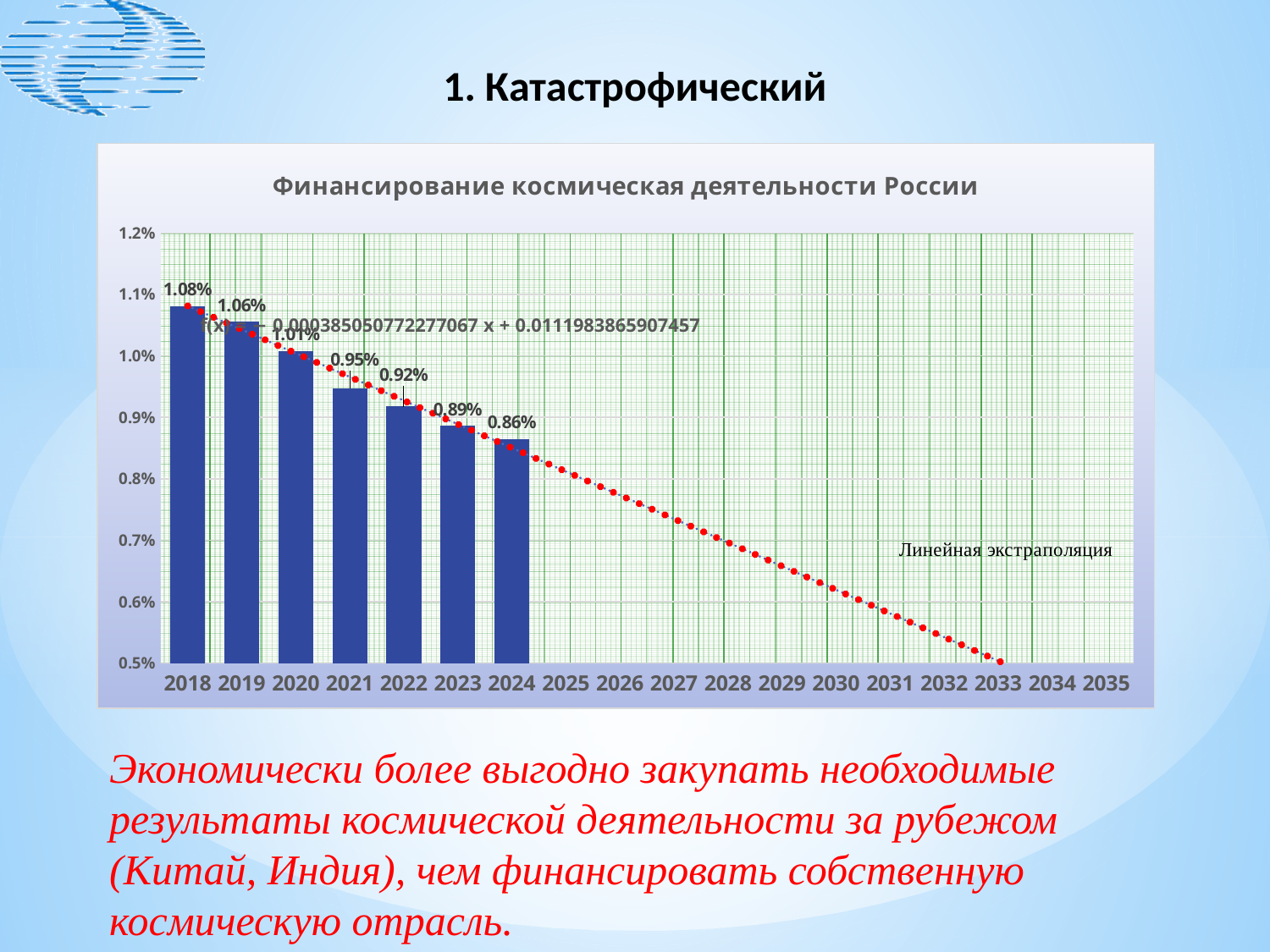
How many bars are plotted in the chart? 7 Which is larger, the value for 2019 or the value for 2022? 2019 What is the difference between the values for 2018 and 2024? 0.22% Do the bar values rise or fall from 2018 to 2024? fall What kind of chart is shown? bar chart What is the value for 2021? 0.95% Is the value for 2023 greater or less than 0.9%? less What is the value for 2024? 0.86% Which year has the lowest bar? 2024 What is the value for 2018? 1.08% Which year has the highest bar? 2018 What is the difference between the values for 2020 and 2021? 0.06%